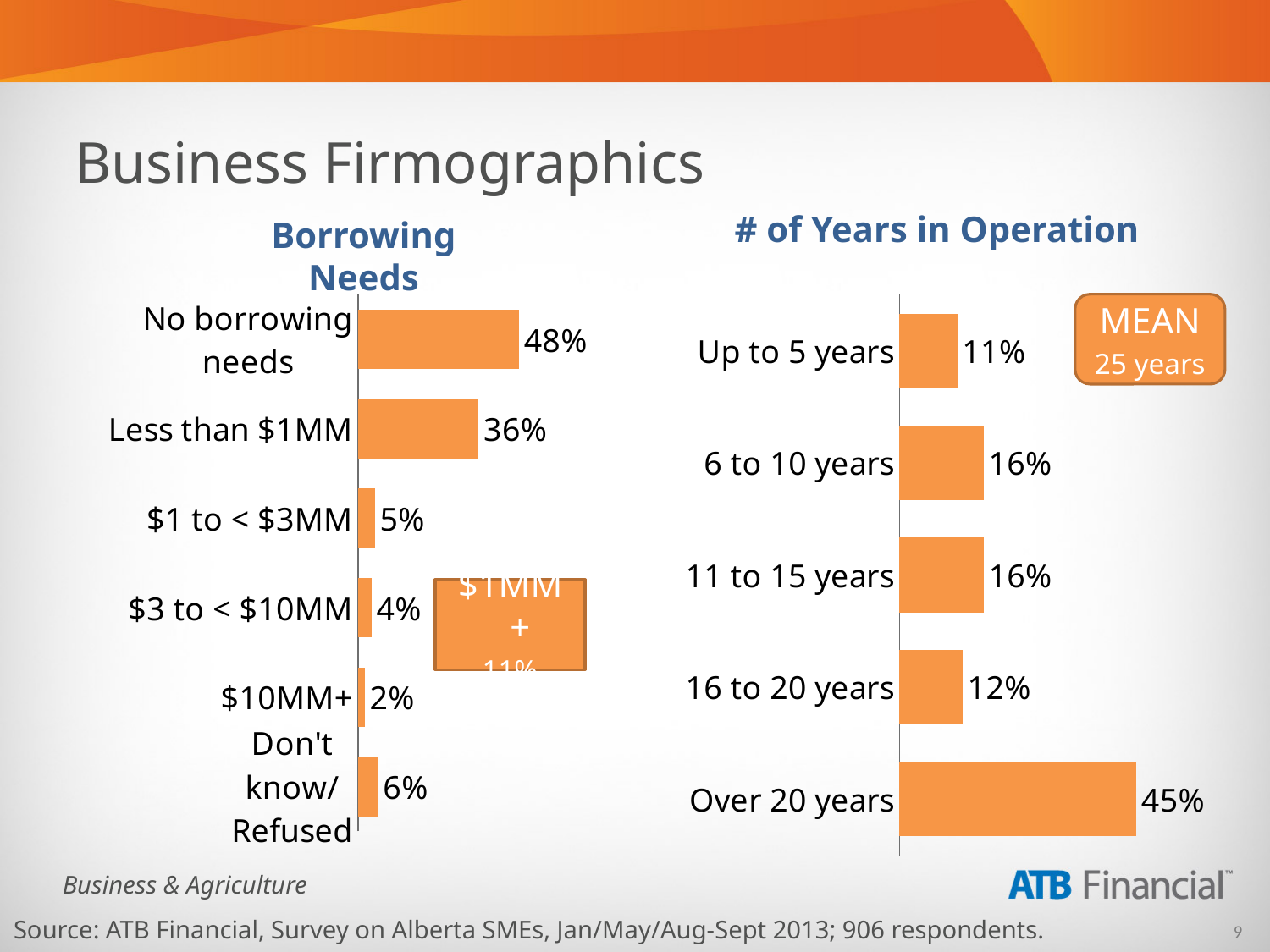
In the # of Years in Operation chart, what is the value for Up to 5 years? 11% In the Borrowing Needs chart, which category has the lowest value? $10MM+ In the Borrowing Needs chart, what percentage of respondents have no borrowing needs? 48% In the # of Years in Operation chart, which is larger: 16 to 20 years or 6 to 10 years? 6 to 10 years In the Borrowing Needs chart, what is the difference between No borrowing needs and Less than $1MM? 12% In the Borrowing Needs chart, what is the value for Less than $1MM? 36% What kind of chart is the # of Years in Operation chart? Bar chart In the # of Years in Operation chart, which category has the highest value? Over 20 years What mean number of years in operation is shown in the callout on the # of Years in Operation chart? 25 years In the # of Years in Operation chart, what is the difference between Over 20 years and 16 to 20 years? 33% In the Borrowing Needs chart, how many categories are shown? 6 In the # of Years in Operation chart, what is the value for Over 20 years? 45%